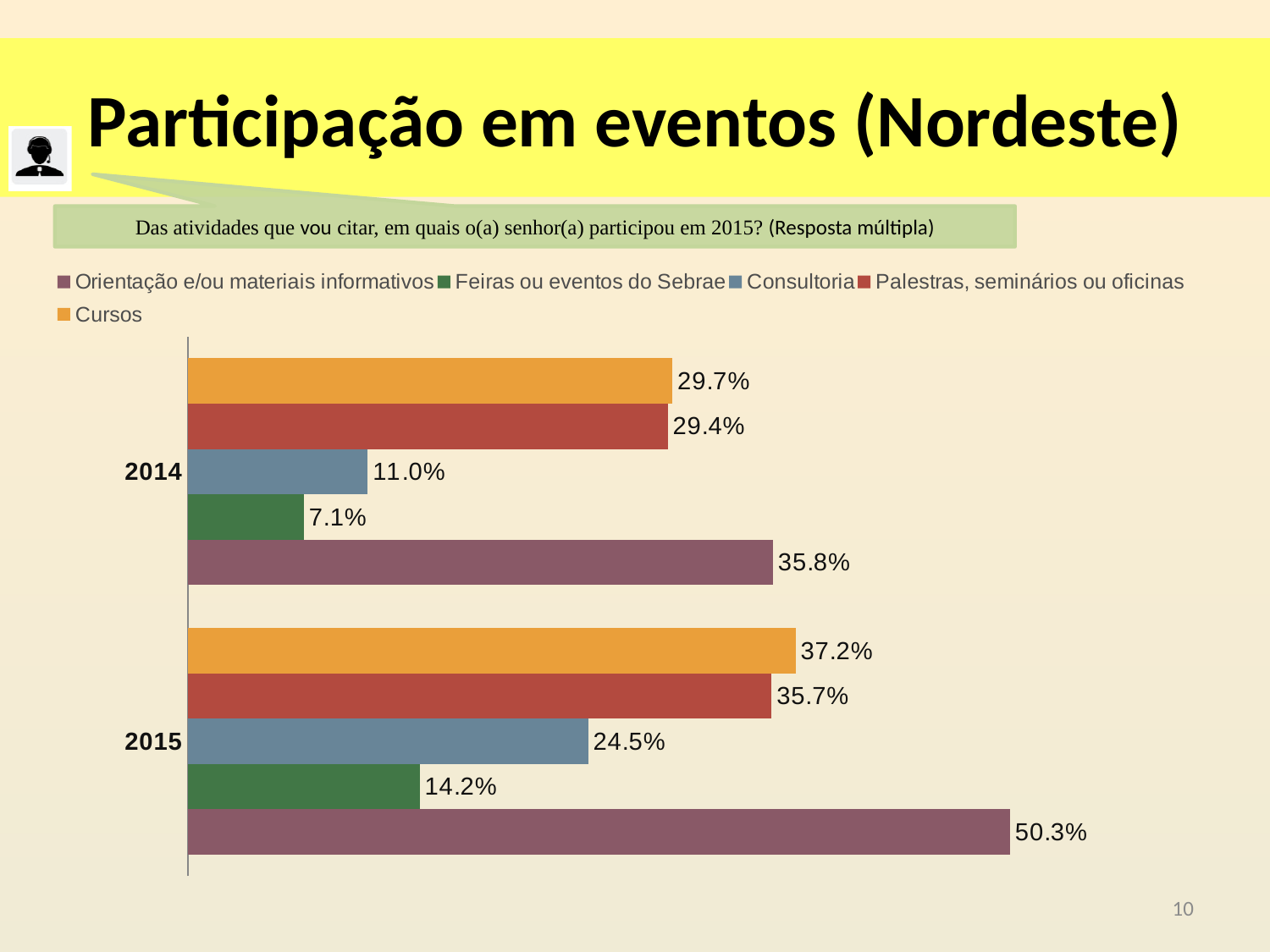
What is the value for Cursos in 2015? 37.2% Which series has the lowest value in 2014? Feiras ou eventos do Sebrae What is the value for Consultoria in 2014? 11.0% How many series does the legend list? 5 Which is larger: Consultoria in 2015 or Consultoria in 2014? Consultoria in 2015 Which series has the highest value in 2015? Orientação e/ou materiais informativos What is the value for Palestras, seminários ou oficinas in 2014? 29.4% What is the value for Feiras ou eventos do Sebrae in 2015? 14.2% Which series is shown in orange in the legend? Cursos What kind of chart is shown on the slide? Bar chart How many year categories are shown on the chart? 2 What is the difference between the Orientação e/ou materiais informativos values for 2015 and 2014? 14.5%